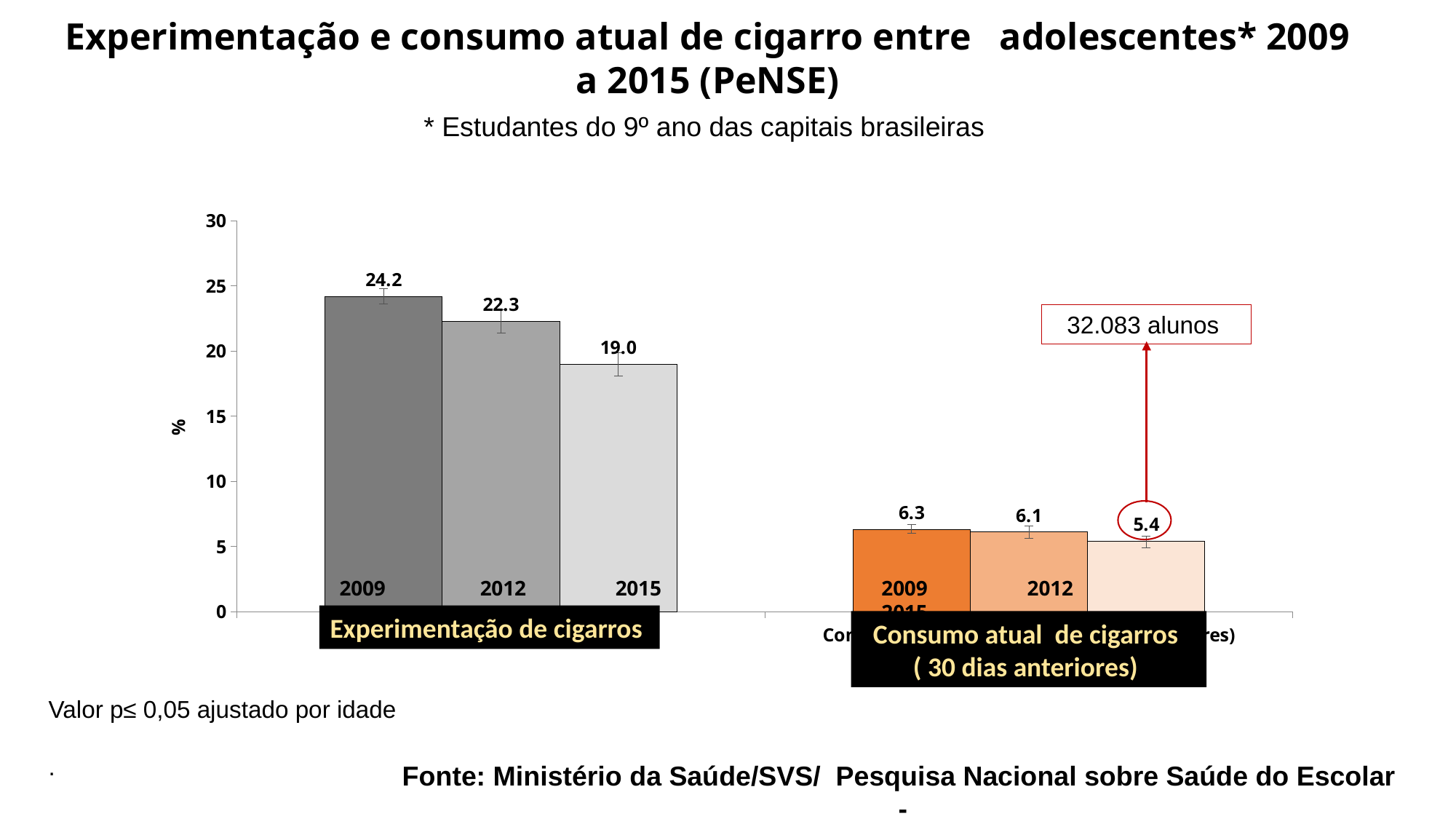
What is the value for 2009 in the Consumo atual de cigarros group? 6.3 What is the difference between the 2009 and 2015 values in the Experimentação de cigarros group? 5.2 What kind of chart is shown on the slide? bar chart What is the value for 2012 in the Consumo atual de cigarros group? 6.1 What is the circled value in the Consumo atual de cigarros group? 5.4 What is the value for 2012 in the Experimentação de cigarros group? 22.3 What is the value for 2009 in the Experimentação de cigarros group? 24.2 Do the values in the Experimentação de cigarros group rise or fall from 2009 to 2015? fall Which year has the highest value in the Experimentação de cigarros group? 2009 What is the value for 2015 in the Experimentação de cigarros group? 19.0 Which is larger: the 2009 value for Experimentação de cigarros or the 2009 value for Consumo atual de cigarros? Experimentação de cigarros How many students does the annotation box say the circled 5.4 value corresponds to? 32.083 alunos